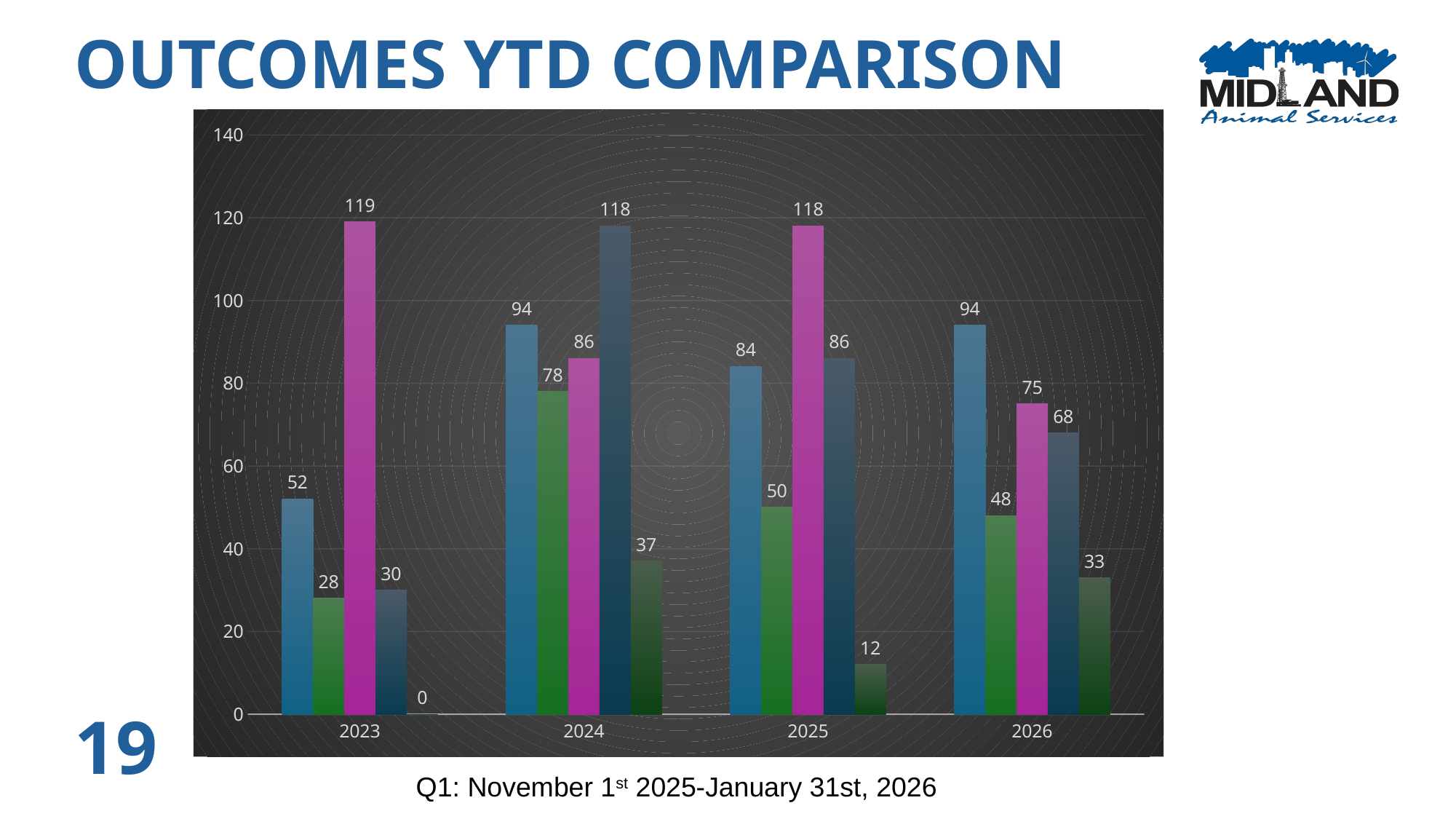
Does the dark green bar rise or fall from 2024 to 2025? Fall What is the value of the magenta bar for 2023? 119 What is the value of the light blue bar for 2026? 94 How many years are shown on the x axis? 4 What is the value of the dark blue bar for 2024? 118 Which is larger: the light blue bar for 2024 or the light blue bar for 2025? 2024 Which year has the highest value for the green bar? 2024 Which year has the lowest value for the dark green bar? 2023 What is the difference between the magenta bar for 2023 and the magenta bar for 2026? 44 What is the value of the dark green bar for 2025? 12 What kind of chart is shown on the slide? Bar chart What is the title of the chart on the slide? OUTCOMES YTD COMPARISON